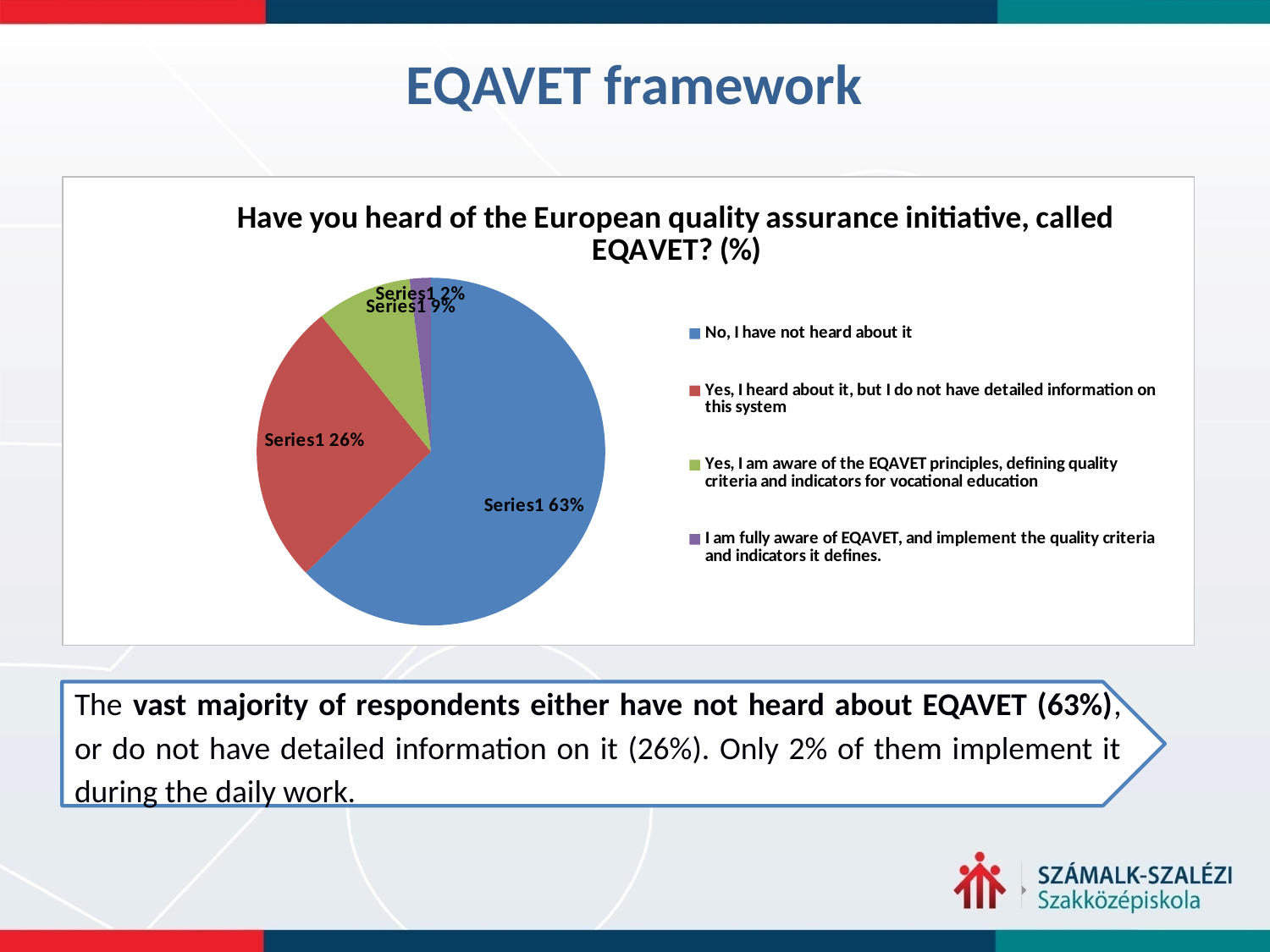
What percentage of respondents answered "Yes, I am aware of the EQAVET principles, defining quality criteria and indicators for vocational education"? 9% Which response has the largest share of the pie? No, I have not heard about it What is the difference in percentage points between "No, I have not heard about it" and "Yes, I heard about it, but I do not have detailed information on this system"? 37 What is the title of the chart? Have you heard of the European quality assurance initiative, called EQAVET? (%) What kind of chart is shown on the slide? pie chart What percentage of respondents answered "No, I have not heard about it"? 63% Which is larger: the share for "Yes, I am aware of the EQAVET principles..." or the share for "I am fully aware of EQAVET..."? Yes, I am aware of the EQAVET principles, defining quality criteria and indicators for vocational education What percentage of respondents answered "I am fully aware of EQAVET, and implement the quality criteria and indicators it defines."? 2% What percentage of respondents answered "Yes, I heard about it, but I do not have detailed information on this system"? 26% What colour is the slice for "No, I have not heard about it"? blue How many slices does the pie chart have? 4 Which response has the smallest share of the pie? I am fully aware of EQAVET, and implement the quality criteria and indicators it defines.